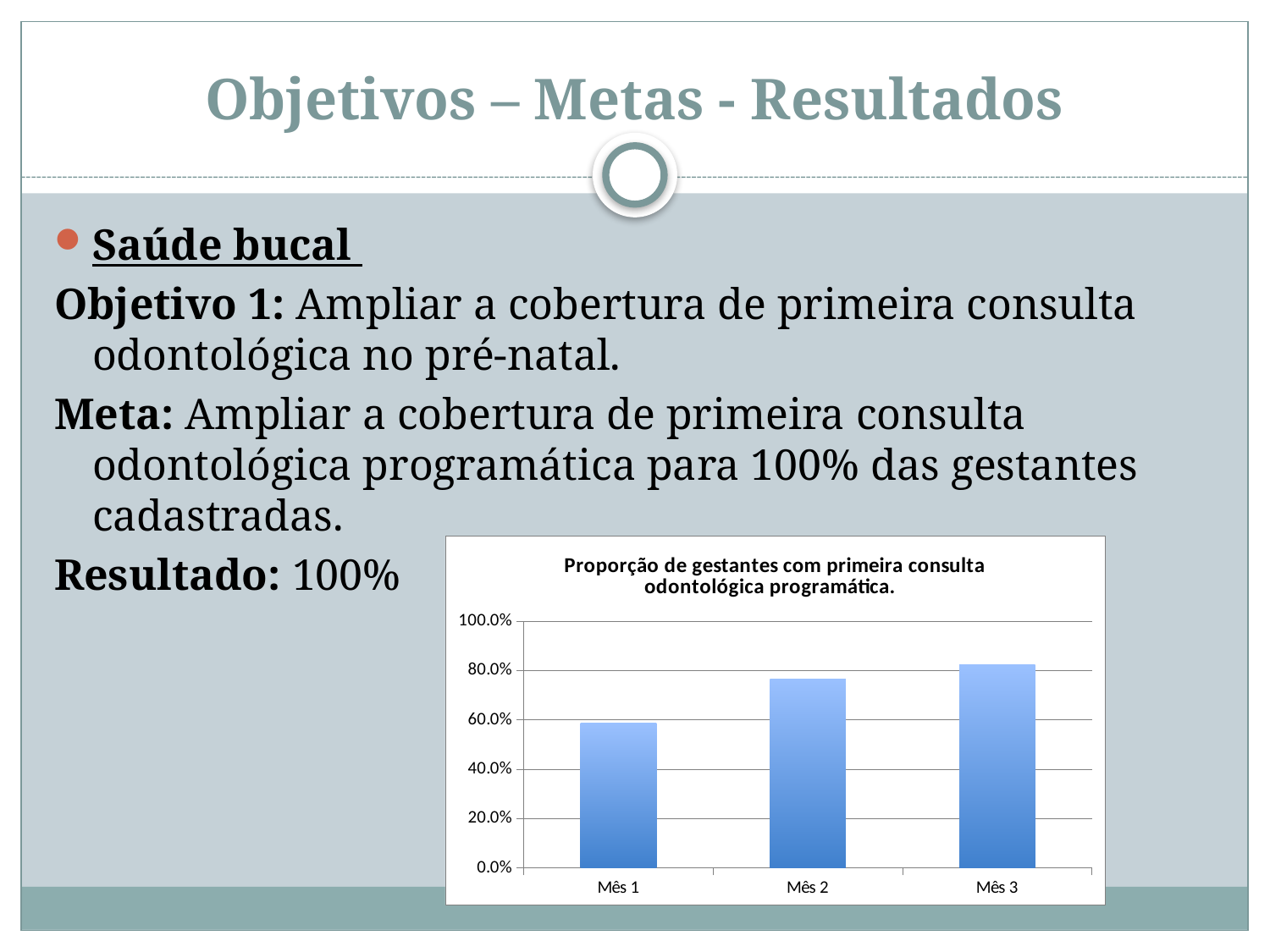
Is the value for Mês 3 greater or less than 100.0%? less Which is larger, the value for Mês 1 or the value for Mês 2? Mês 2 Is the value for Mês 2 greater or less than 80.0%? less Which month has the lowest bar in the chart? Mês 1 What is the highest value shown on the chart's vertical axis? 100.0% Is the value for Mês 1 greater or less than 40.0%? greater What kind of chart is shown on the slide? bar chart How many categories are plotted on the x axis of the chart? 3 Do the values rise or fall from Mês 1 to Mês 3? rise Which month has the highest bar in the chart? Mês 3 What is the title of the chart? Proporção de gestantes com primeira consulta odontológica programática.